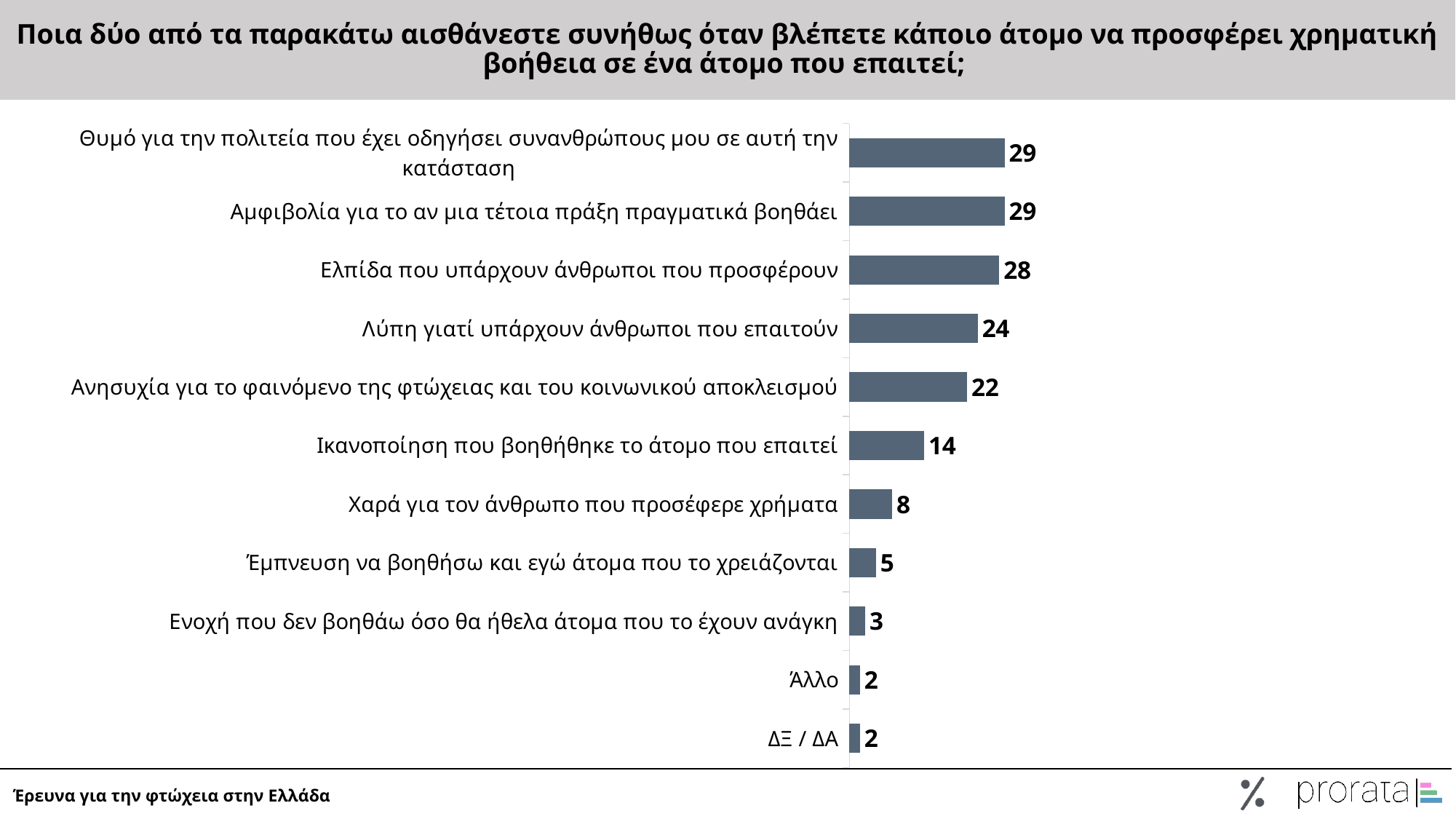
What kind of chart is shown on the slide? Bar chart What is the value for "Χαρά για τον άνθρωπο που προσέφερε χρήματα"? 8 What is the value for "Ικανοποίηση που βοηθήθηκε το άτομο που επαιτεί"? 14 What is the value for "ΔΞ / ΔΑ"? 2 What is the value for "Ενοχή που δεν βοηθάω όσο θα ήθελα άτομα που το έχουν ανάγκη"? 3 How many categories are shown in the chart? 11 What is the difference between the values for "Αμφιβολία για το αν μια τέτοια πράξη πραγματικά βοηθάει" and "Ανησυχία για το φαινόμενο της φτώχειας και του κοινωνικού αποκλεισμού"? 7 Which has a larger value: "Λύπη γιατί υπάρχουν άνθρωποι που επαιτούν" or "Ανησυχία για το φαινόμενο της φτώχειας και του κοινωνικού αποκλεισμού"? Λύπη γιατί υπάρχουν άνθρωποι που επαιτούν What is the difference between the values for "Ικανοποίηση που βοηθήθηκε το άτομο που επαιτεί" and "Έμπνευση να βοηθήσω και εγώ άτομα που το χρειάζονται"? 9 What is the value for "Λύπη γιατί υπάρχουν άνθρωποι που επαιτούν"? 24 Do the bar values increase or decrease from the top of the chart to the bottom? Decrease What is the value for "Ελπίδα που υπάρχουν άνθρωποι που προσφέρουν"? 28